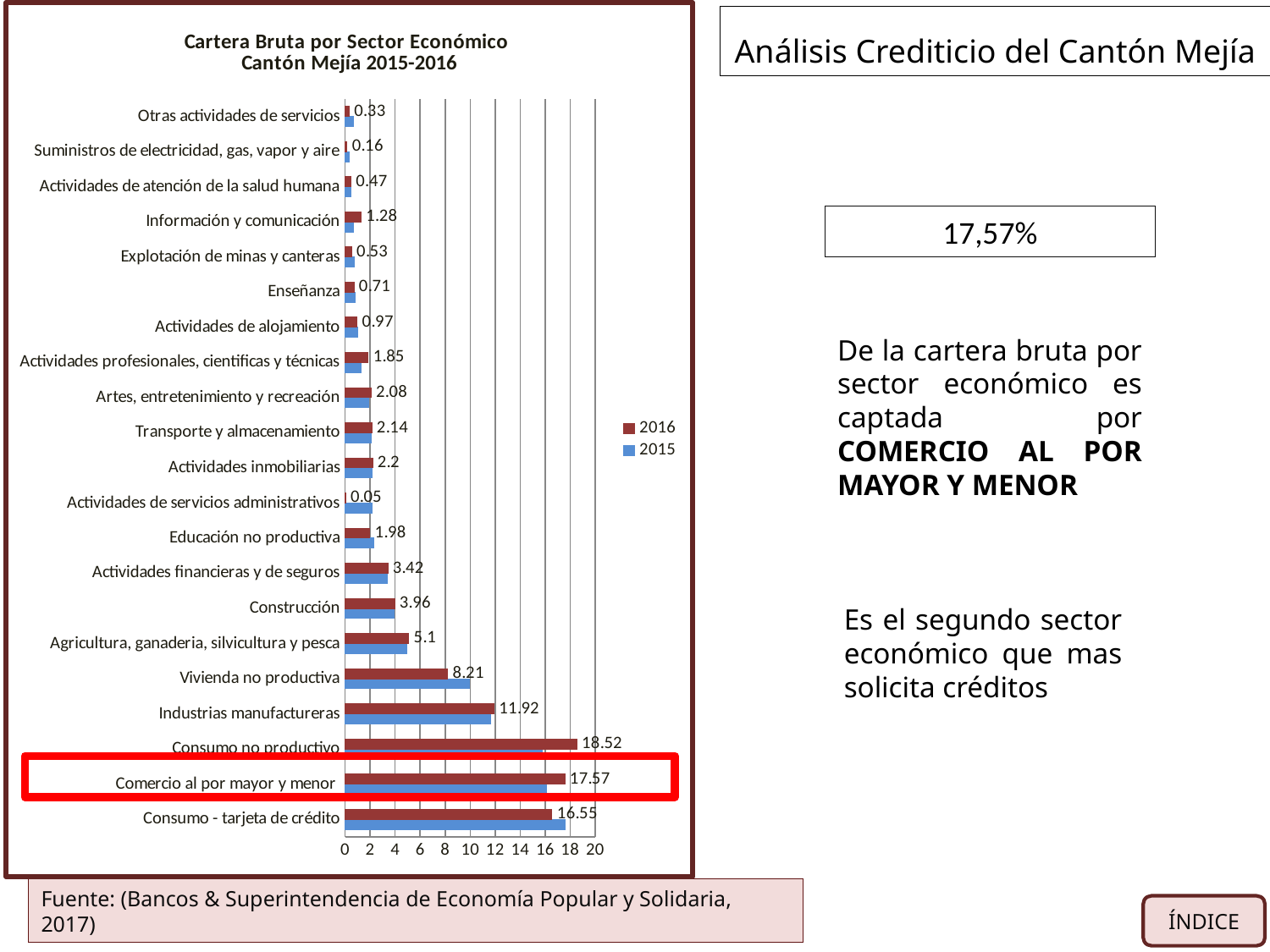
How many sectors (categories) are shown in the chart? 21 What is the 2016 value for Comercio al por mayor y menor? 17.57 What is the 2016 value for Industrias manufactureras? 11.92 What is the title of the chart? Cartera Bruta por Sector Económico Cantón Mejía 2015-2016 What is the difference between the 2016 values for Consumo no productivo and Comercio al por mayor y menor? 0.95 Which has the larger 2016 value, Construcción or Actividades financieras y de seguros? Construcción How many series does the legend list? 2 Which sector has the lowest 2016 value? Actividades de servicios administrativos What type of chart is shown on the slide? Bar chart Is the 2015 value for Consumo - tarjeta de crédito greater or less than 16? greater What is the 2016 value for Agricultura, ganaderia, silvicultura y pesca? 5.1 Which sector has the highest 2016 value? Consumo no productivo